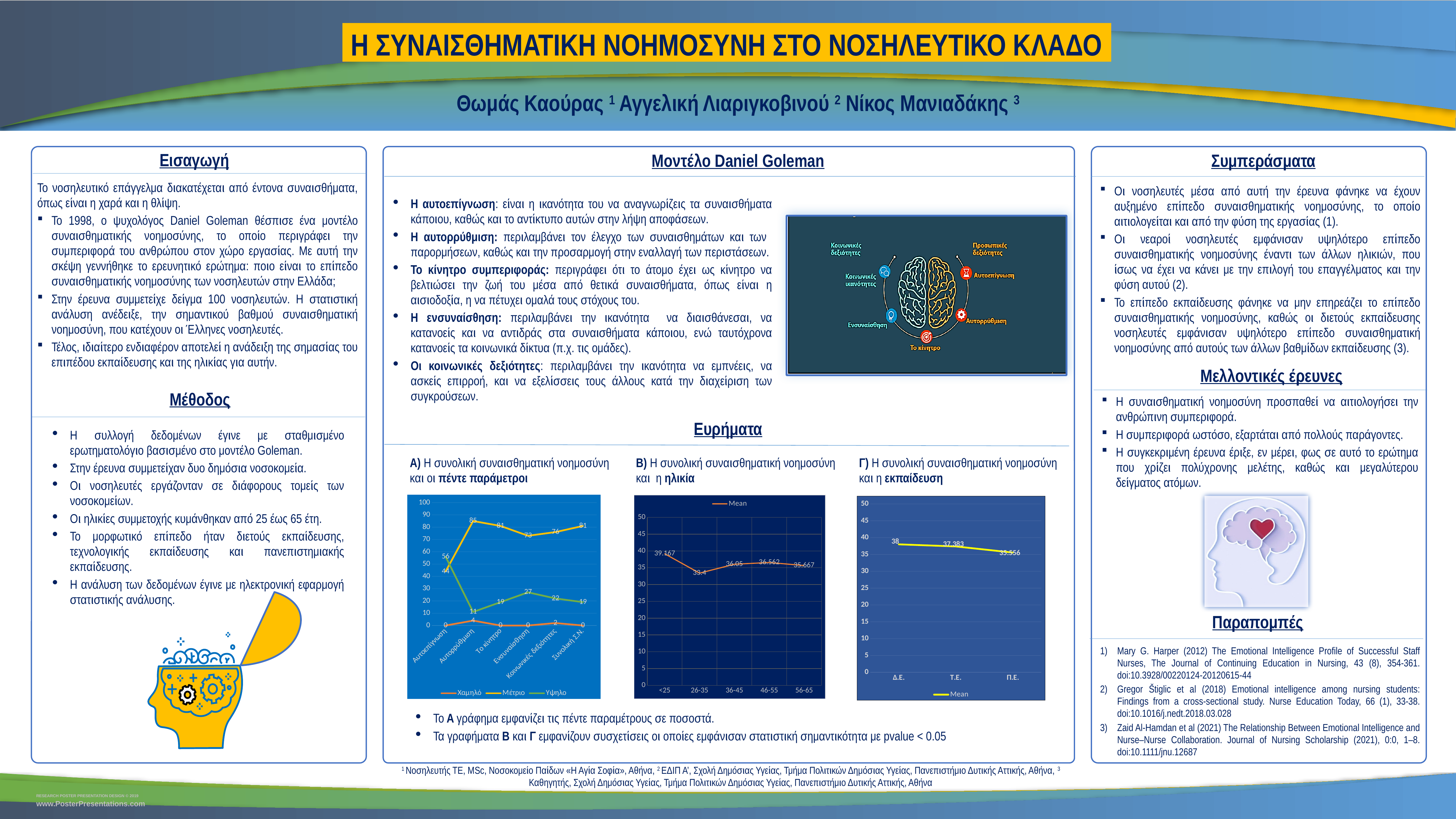
In chart A, how many series does the legend list? 3 In chart A (Η συνολική συναισθηματική νοημοσύνη και οι πέντε παράμετροι), what is the value of the Μέτριο series for Αυτορρύθμιση? 85 In chart A, what is the difference between the Μέτριο and Υψηλό values for Συνολική Σ.Ν.? 62 In chart C, do the Mean values rise or fall from Δ.Ε. to Π.Ε.? fall In chart A, what is the value of the Υψηλό series for Αυτοεπίγνωση? 56 In chart C (Η συνολική συναισθηματική νοημοσύνη και η εκπαίδευση), what is the Mean value for Π.Ε.? 35.556 In chart A, which category has the lowest Μέτριο value? Αυτοεπίγνωση What kind of chart is chart C? line chart In chart B, which age group has the lowest Mean value? 26-35 In chart B (Η συνολική συναισθηματική νοημοσύνη και η ηλικία), what is the Mean value for the <25 age group? 39.167 In chart A, how many categories are shown on the x axis? 6 In chart B, is the Mean value for 36-45 greater or less than 35? greater